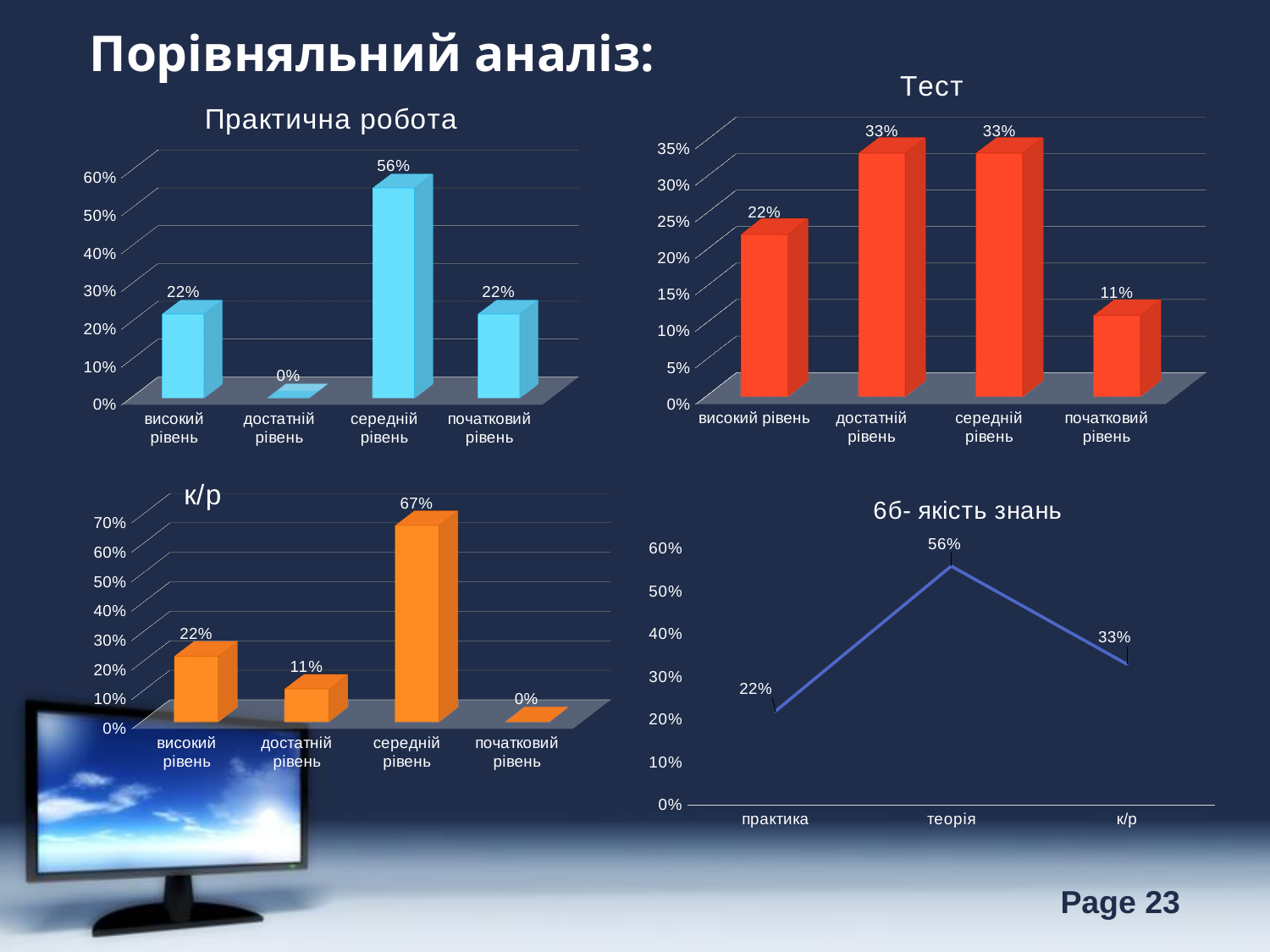
In the 'к/р' chart, what is the value for 'достатній рівень'? 11% In the 'к/р' chart, which category has the highest value? середній рівень In the '6б- якість знань' chart, what is the difference between 'теорія' and 'к/р'? 23% In the 'Тест' chart, how many categories are shown on the x axis? 4 In the 'к/р' chart, which is larger: 'високий рівень' or 'достатній рівень'? високий рівень In the 'Практична робота' chart, which category has the lowest value? достатній рівень In the 'Тест' chart, what is the value for 'початковий рівень'? 11% In the 'Практична робота' chart, what is the value for 'середній рівень'? 56% What kind of chart is the '6б- якість знань' chart? line chart In the 'Тест' chart, what is the difference between 'достатній рівень' and 'високий рівень'? 11% In the '6б- якість знань' chart, what is the value for 'теорія'? 56% What kind of chart is the 'Практична робота' chart? bar chart